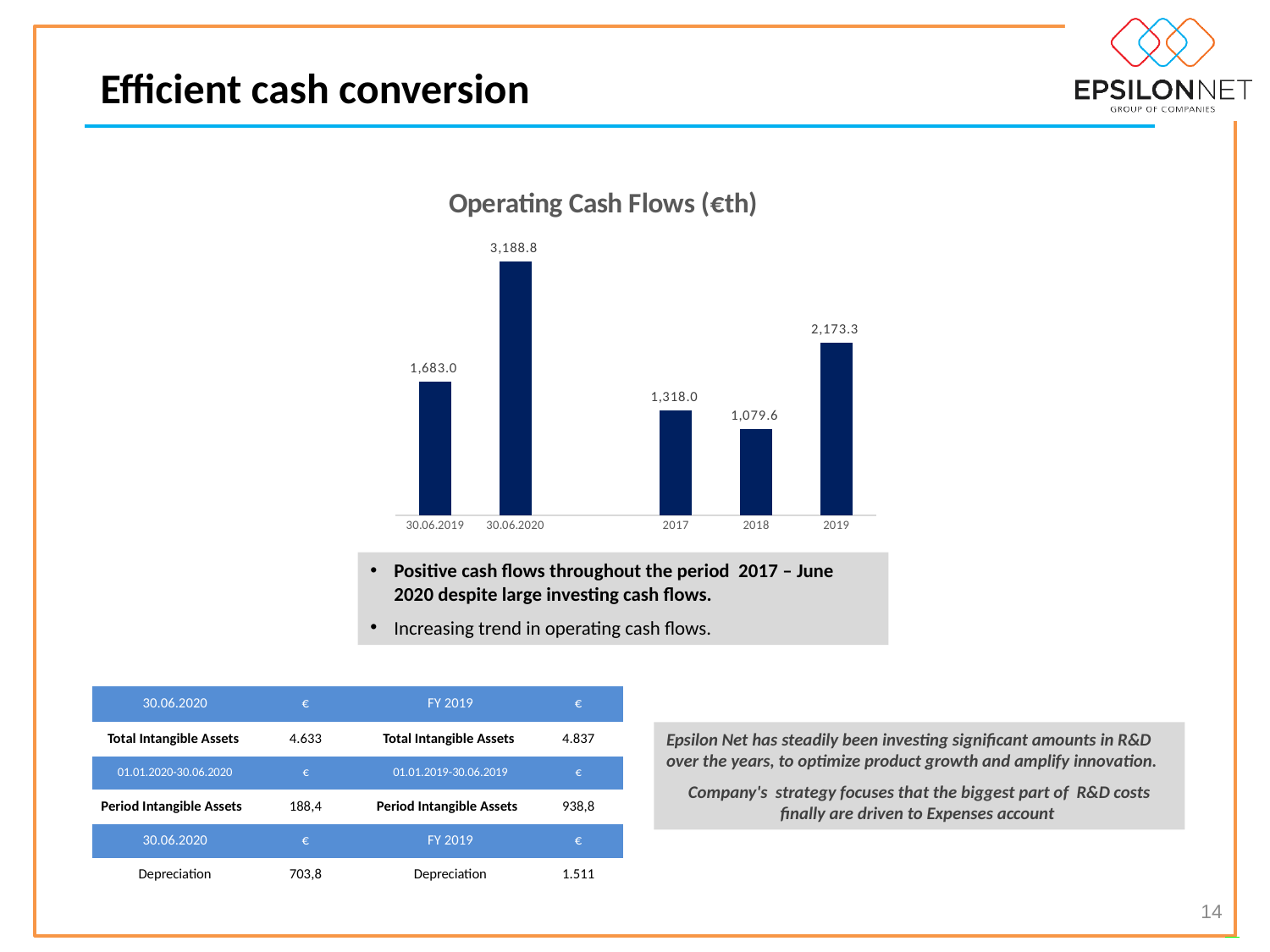
Which category has the highest operating cash flow? 30.06.2020 Which category has the lowest operating cash flow? 2018 What is the operating cash flow value for 2019? 2,173.3 What is the operating cash flow value for 2018? 1,079.6 What type of chart is used to show Operating Cash Flows? Bar chart What is the difference between the operating cash flow for 2019 and 2018? 1,093.7 What is the operating cash flow value for 30.06.2020? 3,188.8 How many bars are shown in the Operating Cash Flows chart? 5 What is the difference between the operating cash flow for 30.06.2020 and 30.06.2019? 1,505.8 What is the operating cash flow value for 30.06.2019? 1,683.0 What is the title of the chart on the slide? Operating Cash Flows (€th) Which is larger, the operating cash flow for 2017 or for 2018? 2017